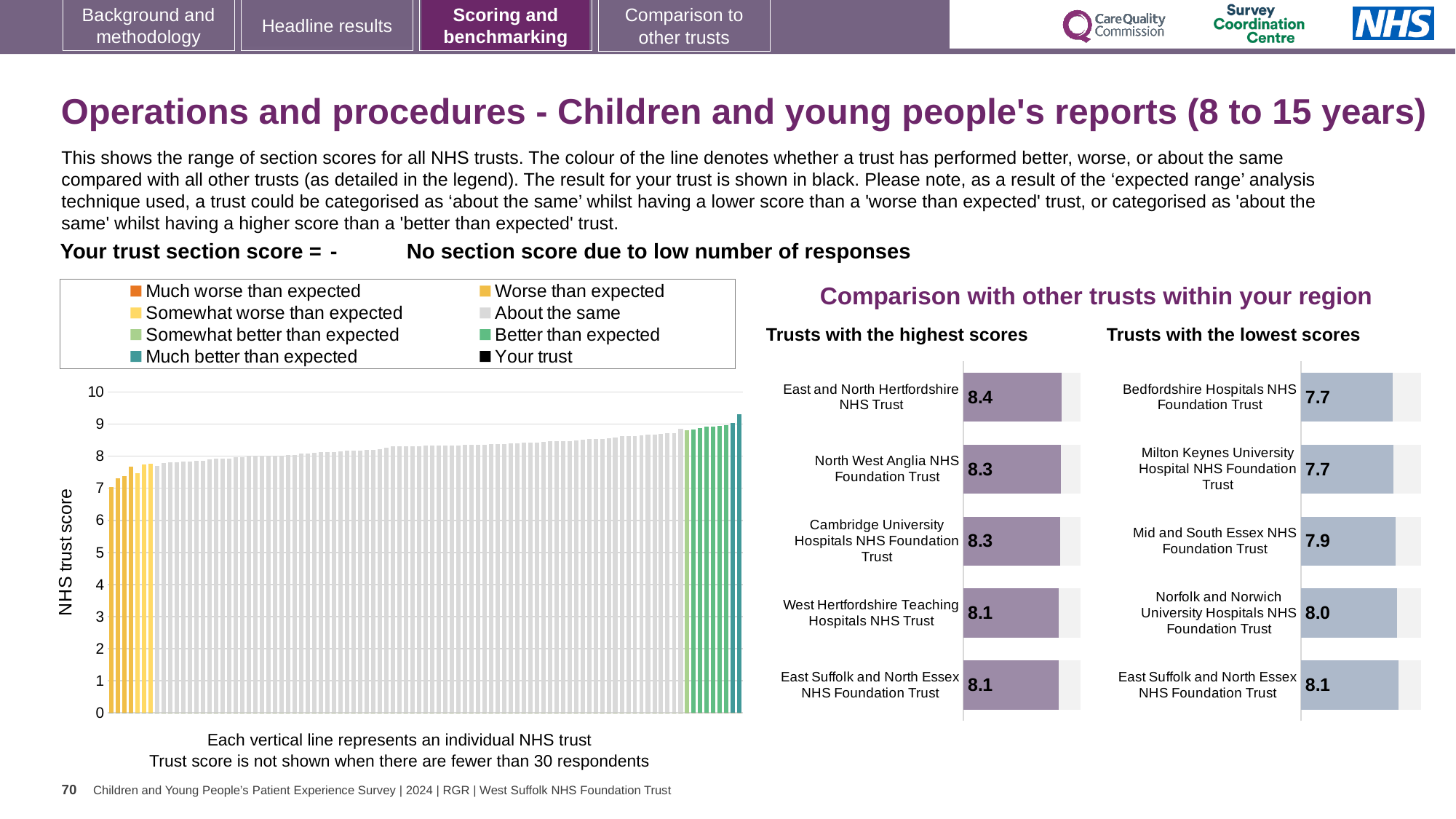
In the 'Trusts with the lowest scores' chart, what is the difference between the scores of East Suffolk and North Essex NHS Foundation Trust and Bedfordshire Hospitals NHS Foundation Trust? 0.4 How many trusts are listed in the 'Trusts with the highest scores' chart? 5 In the 'Trusts with the highest scores' chart, what is the score for East and North Hertfordshire NHS Trust? 8.4 In the 'Trusts with the lowest scores' chart, what is the score for Mid and South Essex NHS Foundation Trust? 7.9 What kind of chart is the large chart on the left showing NHS trust scores? Bar chart In the 'Trusts with the highest scores' chart, what is the difference between the scores of East and North Hertfordshire NHS Trust and East Suffolk and North Essex NHS Foundation Trust? 0.3 What is the y-axis label of the large chart on the left? NHS trust score In the 'Trusts with the highest scores' chart, which has the higher score: West Hertfordshire Teaching Hospitals NHS Trust or North West Anglia NHS Foundation Trust? North West Anglia NHS Foundation Trust How many entries does the legend of the large chart on the left list? 8 In the large chart on the left, do the trust scores rise or fall from left to right? Rise In the 'Trusts with the lowest scores' chart, what is the score for Norfolk and Norwich University Hospitals NHS Foundation Trust? 8.0 In the 'Trusts with the highest scores' chart, which trust has the highest score? East and North Hertfordshire NHS Trust